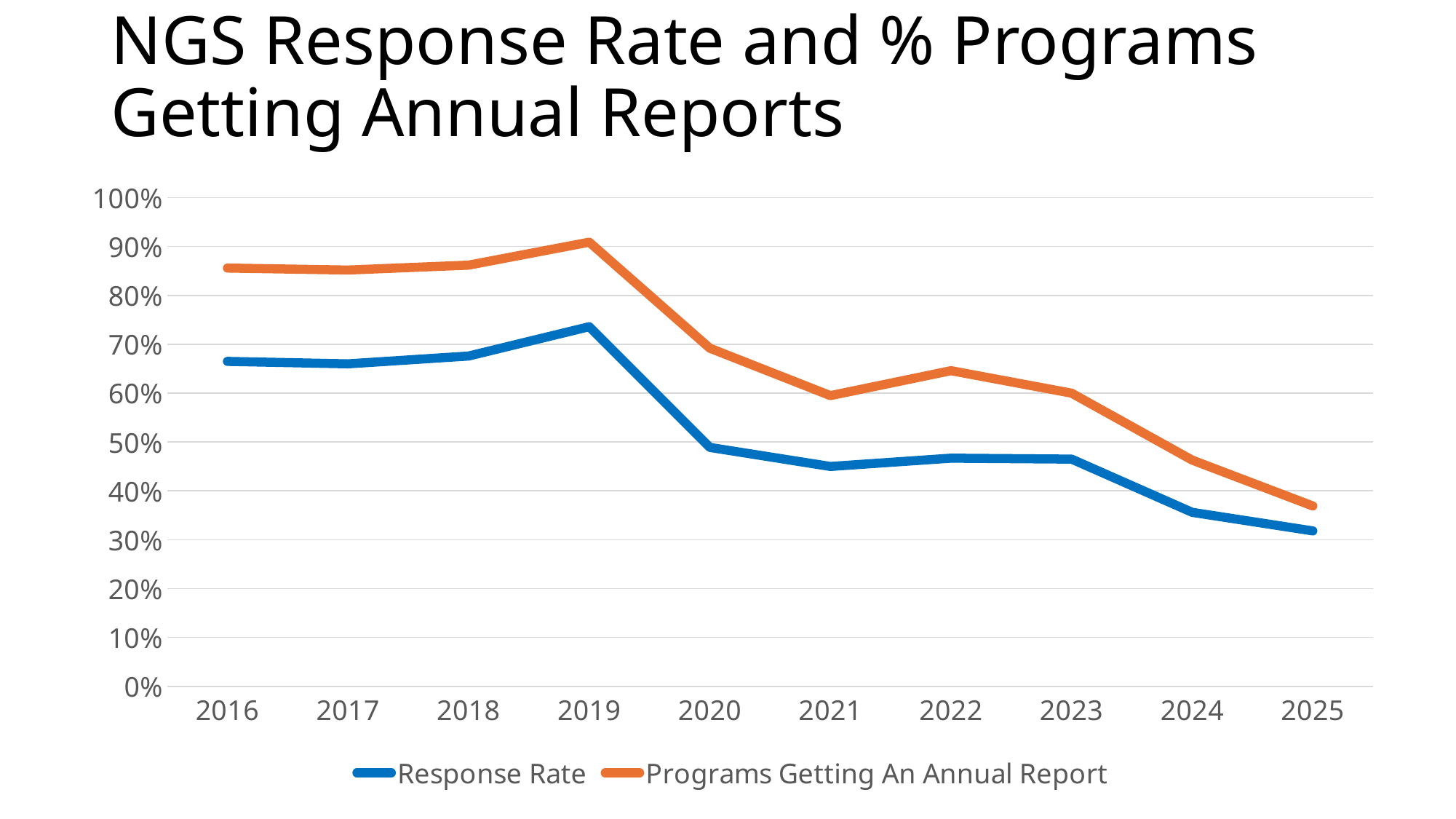
Which is larger, the Response Rate in 2019 or in 2020? 2019 In which year is the value for Programs Getting An Annual Report highest? 2019 How many years are plotted along the x axis? 10 What kind of chart is shown on the slide? line chart Is the Response Rate in 2019 greater or less than 70%? greater Overall, do the values rise or fall from 2016 to 2025? fall Is the value for Programs Getting An Annual Report in 2020 greater or less than 60%? greater Is the Response Rate in 2025 greater or less than 40%? less Which colour is used for the Response Rate line? blue In which year is the Response Rate highest? 2019 In which year is the Response Rate lowest? 2025 How many series does the legend list? 2